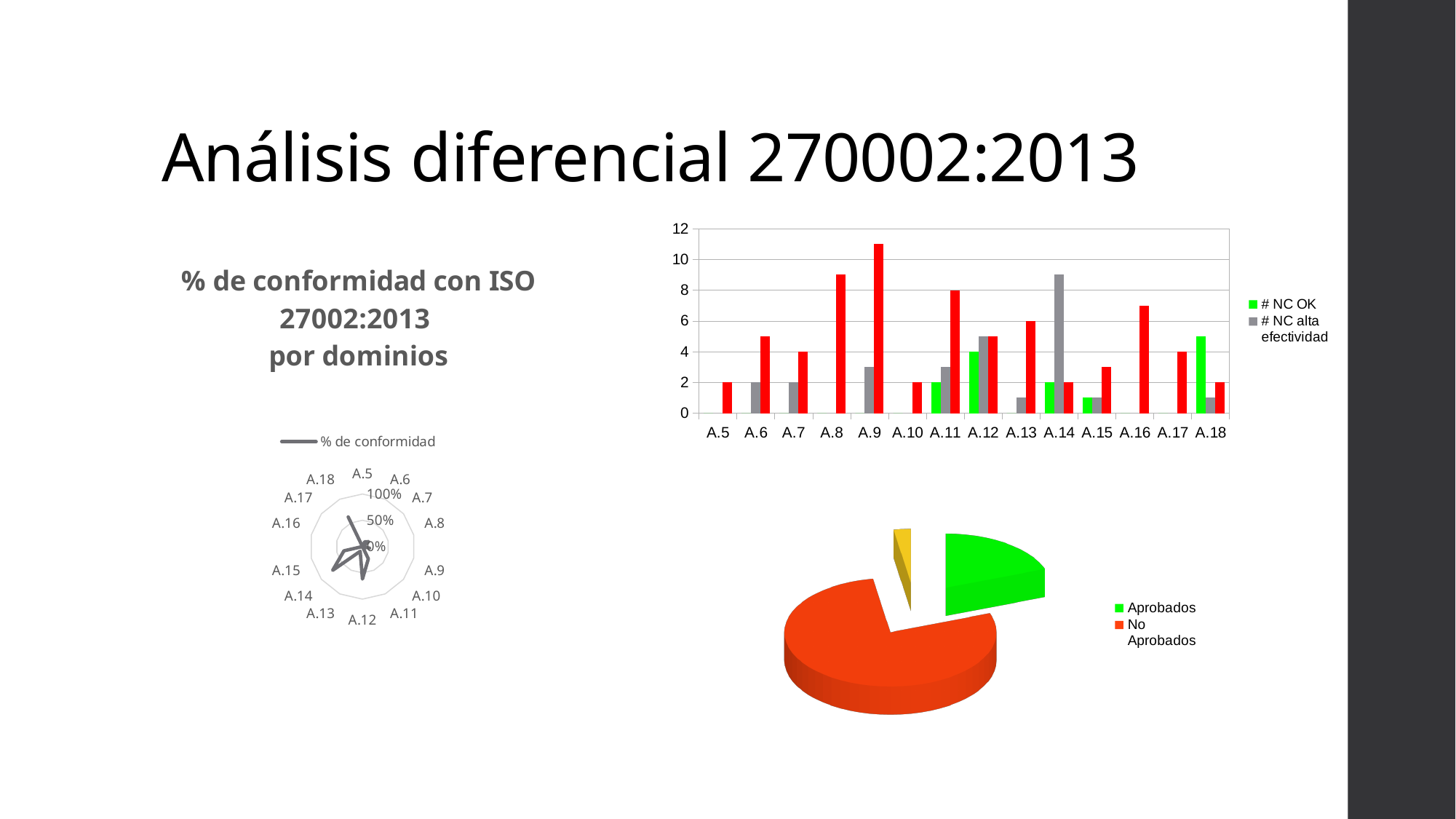
What kind of chart is the chart titled '% de conformidad con ISO 27002:2013 por dominios'? Radar chart How many series does the legend of the bar chart at the top right list? 2 In the bar chart at the top right, is the red bar for A.9 greater or less than 10? greater In the bar chart at the top right, which category has the tallest gray # NC alta efectividad bar? A.14 In the bar chart at the top right, what is the value of the red bar for A.7? 4 In the bar chart at the top right, which category has the tallest red bar? A.9 In the bar chart at the top right, what is the value of the green # NC OK bar for A.12? 4 In the bar chart at the top right, is the gray # NC alta efectividad bar for A.14 greater or less than 8? greater In the bar chart at the top right, which is larger: the green # NC OK bar for A.18 or the green # NC OK bar for A.12? A.18 In the bar chart at the top right, what is the value of the red bar for A.11? 8 How many categories are shown on the x axis of the bar chart at the top right? 14 In the pie chart at the bottom right, which slice is larger: Aprobados or No Aprobados? No Aprobados